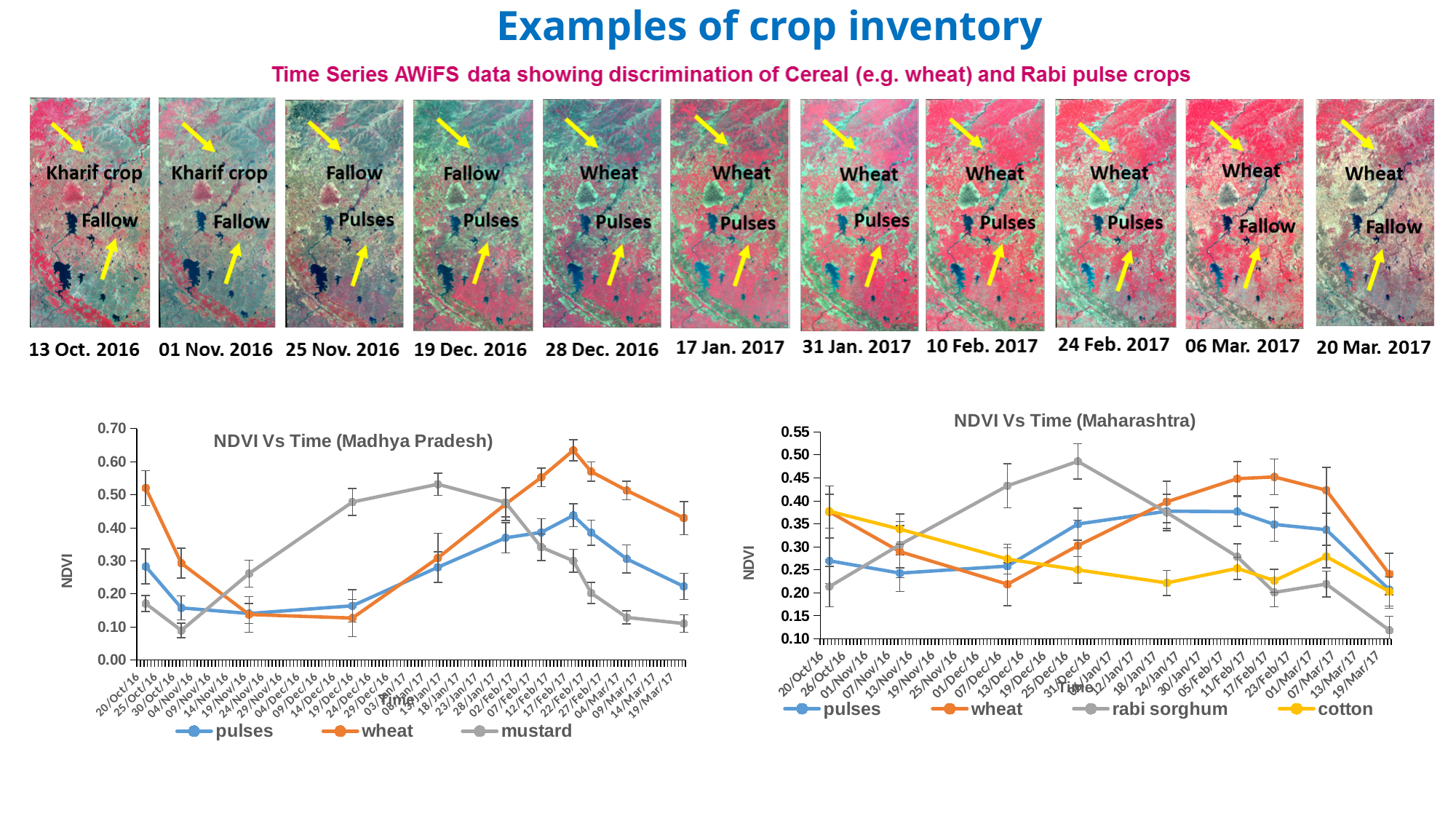
In the 'NDVI Vs Time (Maharashtra)' chart, which series has the highest value at 31/Dec/16? rabi sorghum What kind of chart is the 'NDVI Vs Time (Madhya Pradesh)' chart? line chart In the 'NDVI Vs Time (Madhya Pradesh)' chart, at 20/Oct/16, which is larger: wheat or pulses? wheat In the 'NDVI Vs Time (Maharashtra)' chart, is the rabi sorghum value at 19/Mar/17 greater or less than 0.15? less How many series does the legend of the 'NDVI Vs Time (Maharashtra)' chart list? 4 How many series does the legend of the 'NDVI Vs Time (Madhya Pradesh)' chart list? 3 In the 'NDVI Vs Time (Maharashtra)' chart, is the cotton value at 20/Oct/16 greater or less than 0.30? greater In the 'NDVI Vs Time (Madhya Pradesh)' chart, which series reaches the highest NDVI value? wheat In the 'NDVI Vs Time (Madhya Pradesh)' chart, is the peak value of the wheat series greater or less than 0.50? greater In the 'NDVI Vs Time (Madhya Pradesh)' chart, which series are listed in the legend? pulses, wheat, mustard In the 'NDVI Vs Time (Maharashtra)' chart, at 11/Feb/17, which is larger: wheat or pulses? wheat In the 'NDVI Vs Time (Madhya Pradesh)' chart, does the mustard series rise or fall from 22/Feb/17 to 19/Mar/17? fall